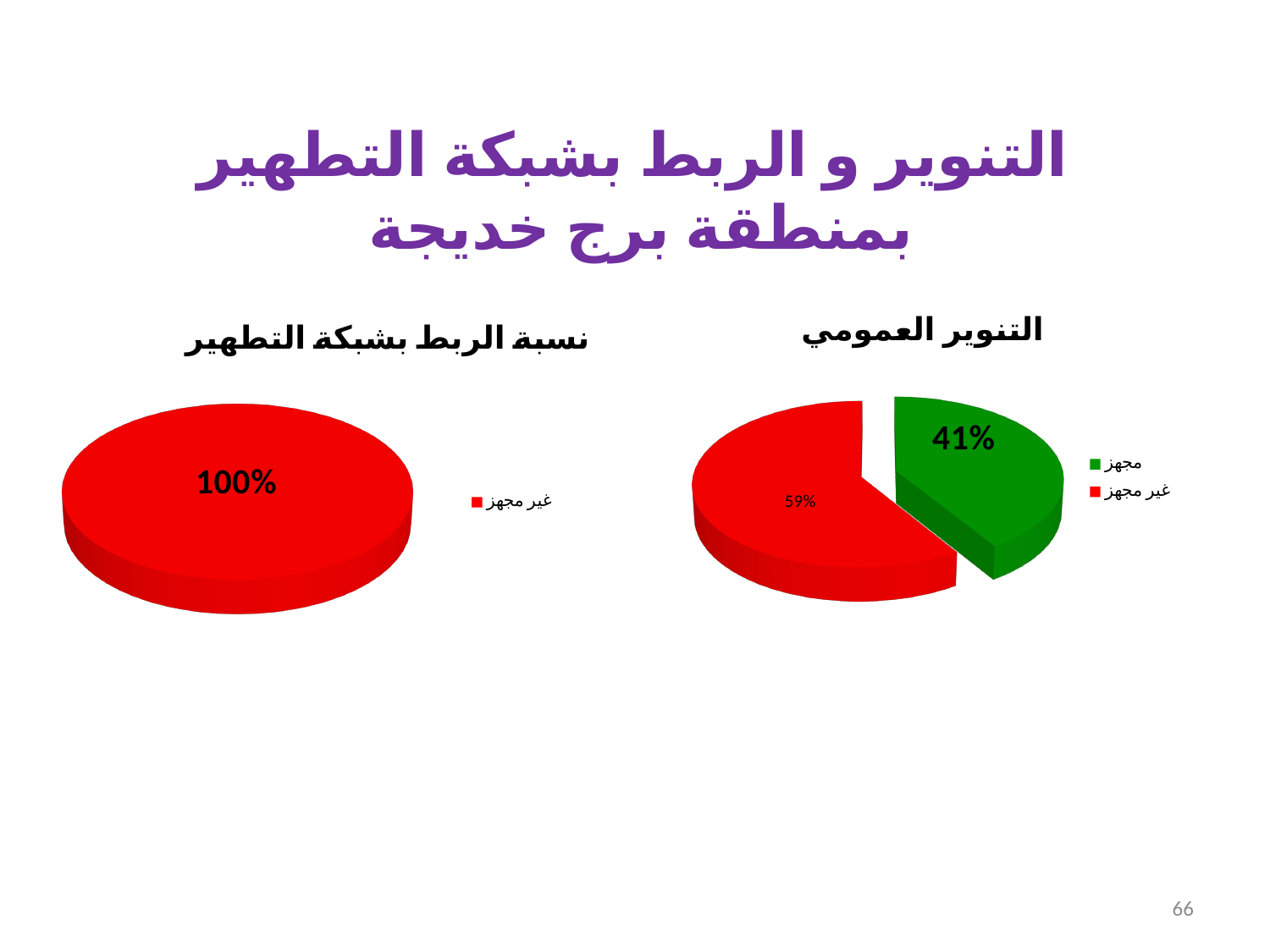
In the chart titled "التنوير العمومي", what percentage is shown for "غير مجهز"? 59% In the chart titled "التنوير العمومي", which is larger: "مجهز" or "غير مجهز"? غير مجهز In the chart titled "التنوير العمومي", what colour is the slice for "مجهز"? Green In the chart titled "التنوير العمومي", which category has the smallest share? مجهز In the chart titled "نسبة الربط بشبكة التطهير", how many entries does the legend list? 1 In the chart titled "التنوير العمومي", which category has the largest share? غير مجهز In the chart titled "نسبة الربط بشبكة التطهير", what percentage is shown for "غير مجهز"? 100% In the chart titled "التنوير العمومي", how many entries does the legend list? 2 What type of chart is the chart titled "نسبة الربط بشبكة التطهير"? Pie chart In the chart titled "التنوير العمومي", how many slices does the pie have? 2 In the chart titled "التنوير العمومي", what is the difference in percentage points between "غير مجهز" and "مجهز"? 18 In the chart titled "التنوير العمومي", what percentage is shown for "مجهز"? 41%